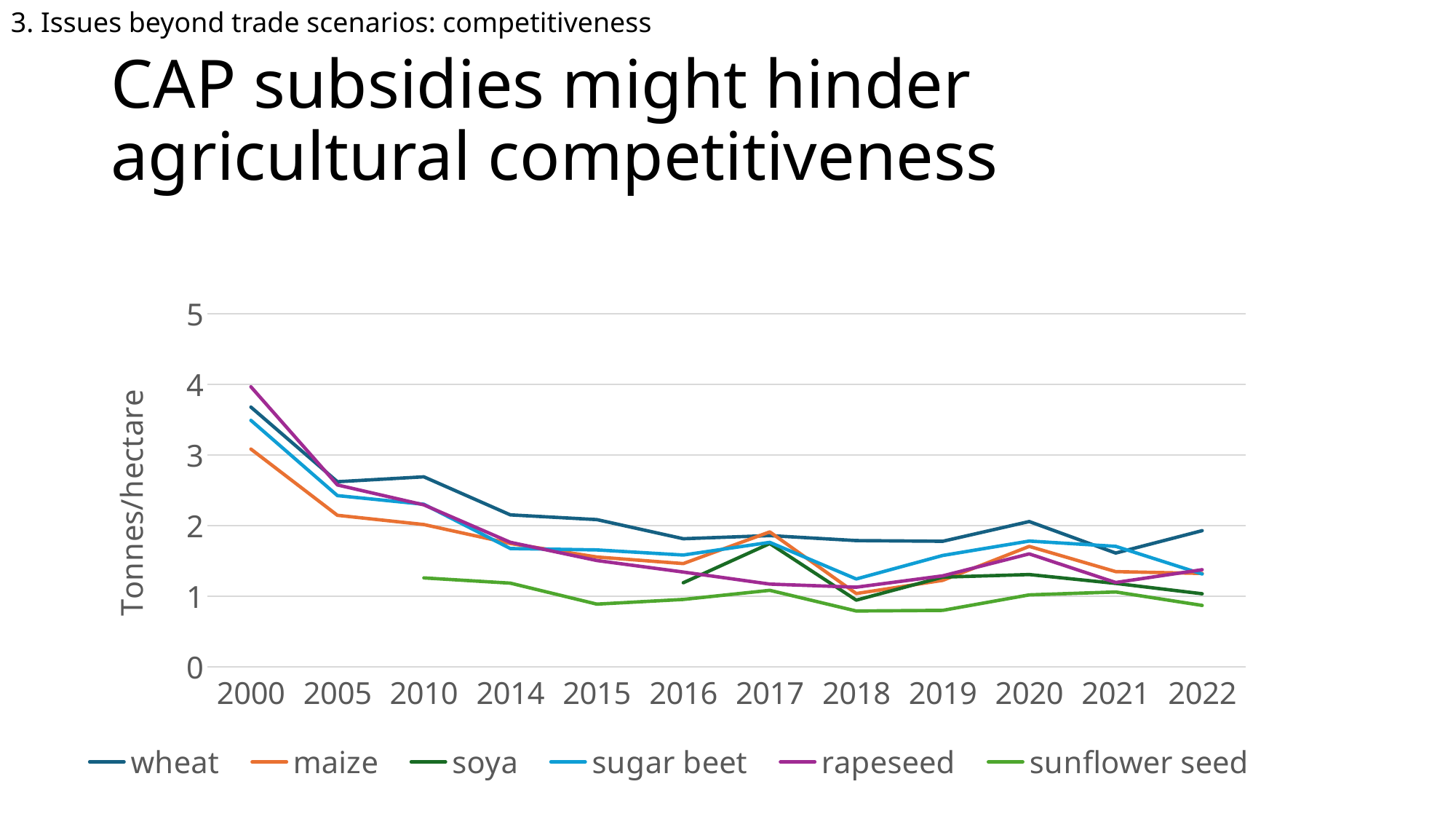
Does the wheat line rise or fall overall from 2000 to 2022? fall How many series does the legend list? 6 In which year does the sunflower seed line begin? 2010 Which series has the highest value in 2000? rapeseed What kind of chart is shown on the slide? line chart Is the value for rapeseed in 2000 greater or less than 3? greater How many years are shown along the x axis? 12 Which series has the lowest value in 2018? sunflower seed Is the value for wheat in 2010 greater or less than 2? greater What is the label on the y axis? Tonnes/hectare Is the value for sunflower seed in 2022 greater or less than 1? less In 2005, which is larger, the value for wheat or the value for maize? wheat